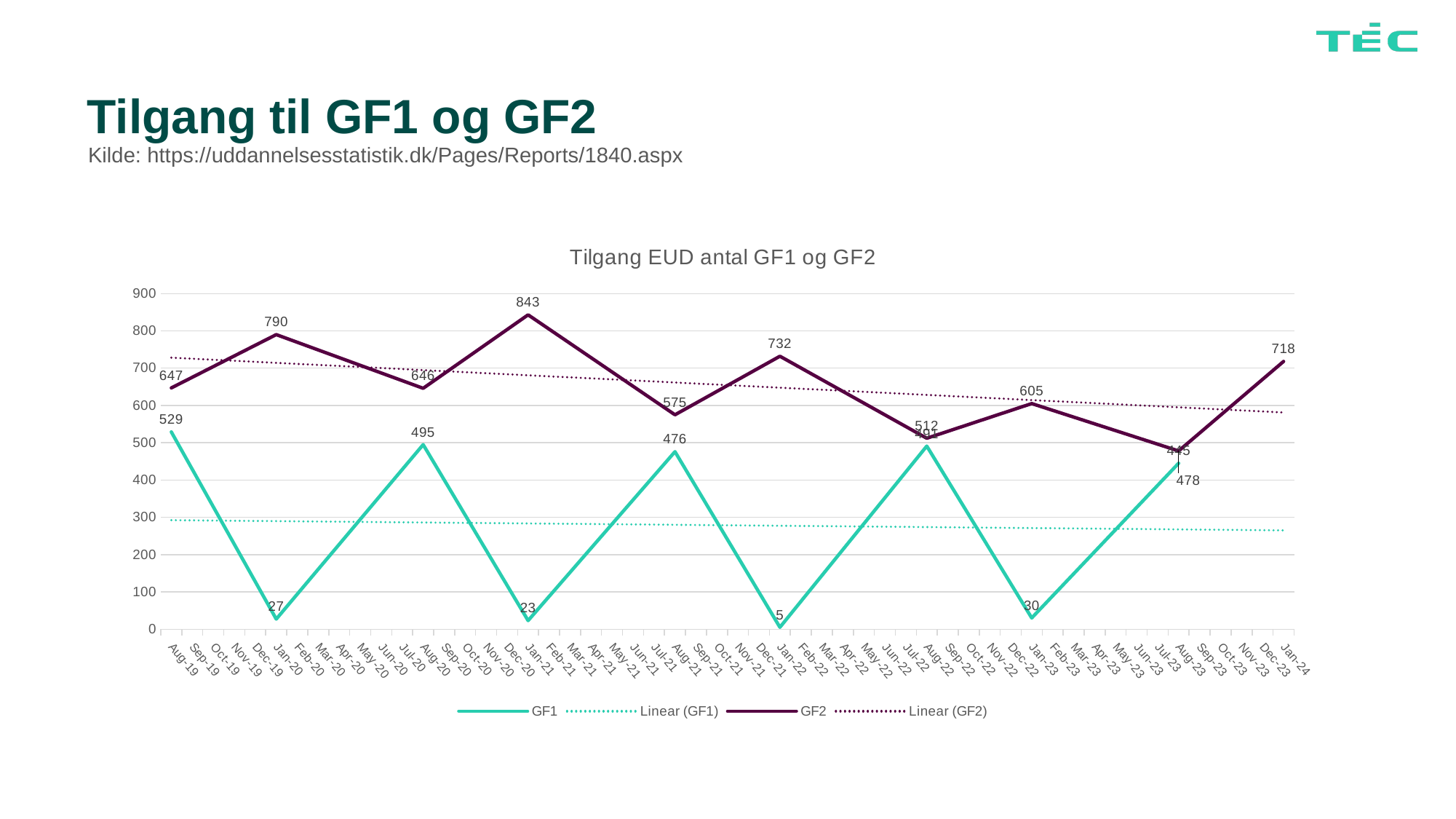
At which month does the GF1 series reach its lowest value? Jan-22 What is the difference between the GF2 values for Jan-21 and Jan-20? 53 What is the GF2 value for Jan-21? 843 What type of chart is shown on the slide? Line chart Which is larger, the GF2 value for Aug-21 or the GF2 value for Jan-22? Jan-22 How many series does the legend list? 4 What is the GF2 value for Aug-19? 647 Does the Linear (GF2) trendline rise or fall along the x axis? Fall What is the GF1 value for Aug-19? 529 What is the GF1 value for Aug-23? 445 What is the title of the chart? Tilgang EUD antal GF1 og GF2 At which month does the GF2 series reach its highest value? Jan-21